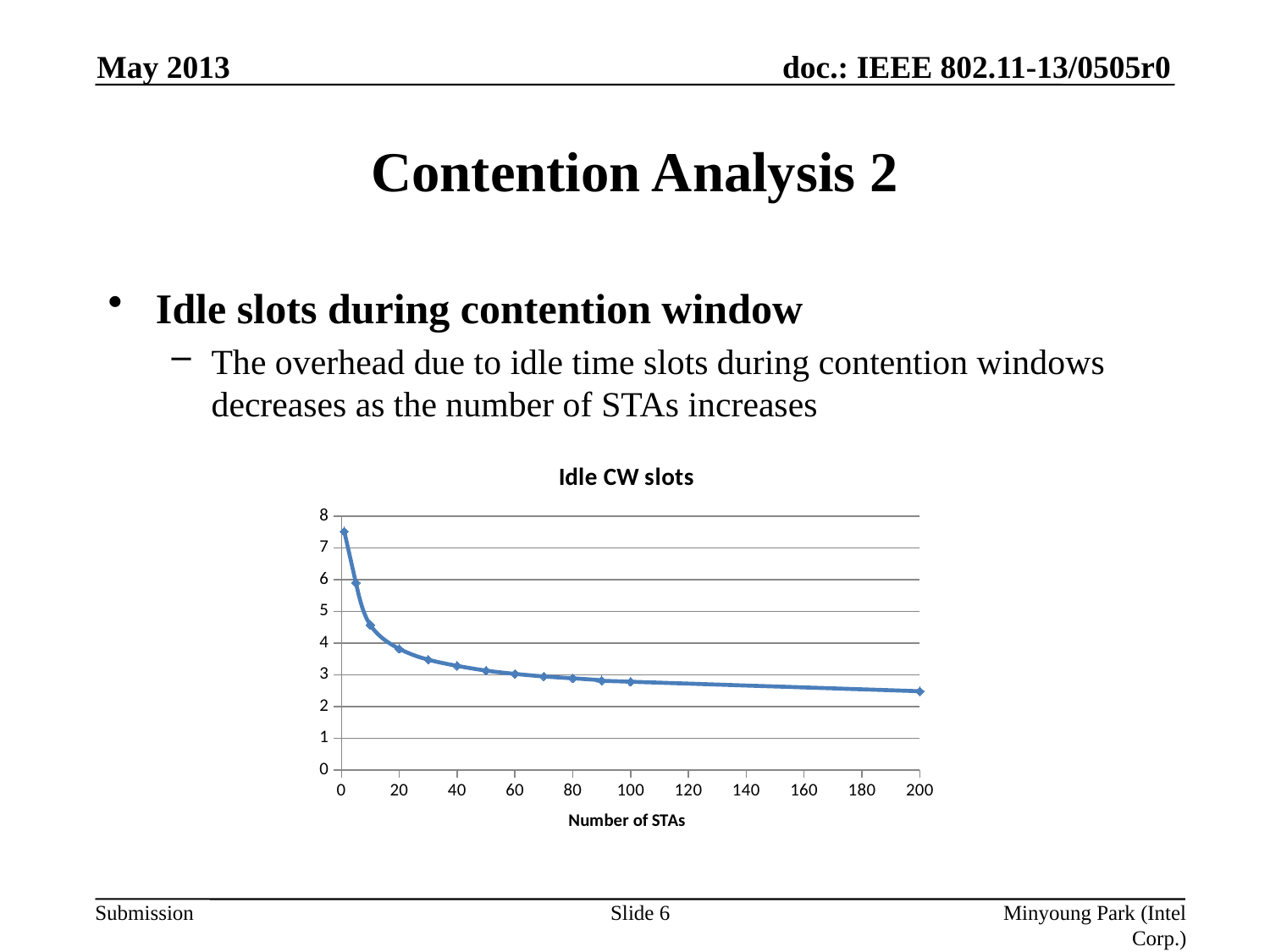
Is the value at 10 STAs greater or less than 4? greater What is the title of the chart? Idle CW slots Is the value at 100 STAs greater or less than 3? less Do the values rise or fall as the number of STAs increases? fall How many data points are plotted on the line? 13 Is the value at 20 STAs greater or less than 3? greater What is the label of the x axis of the chart? Number of STAs Which has the larger value: 20 STAs or 200 STAs? 20 STAs What kind of chart is shown on the slide? line chart